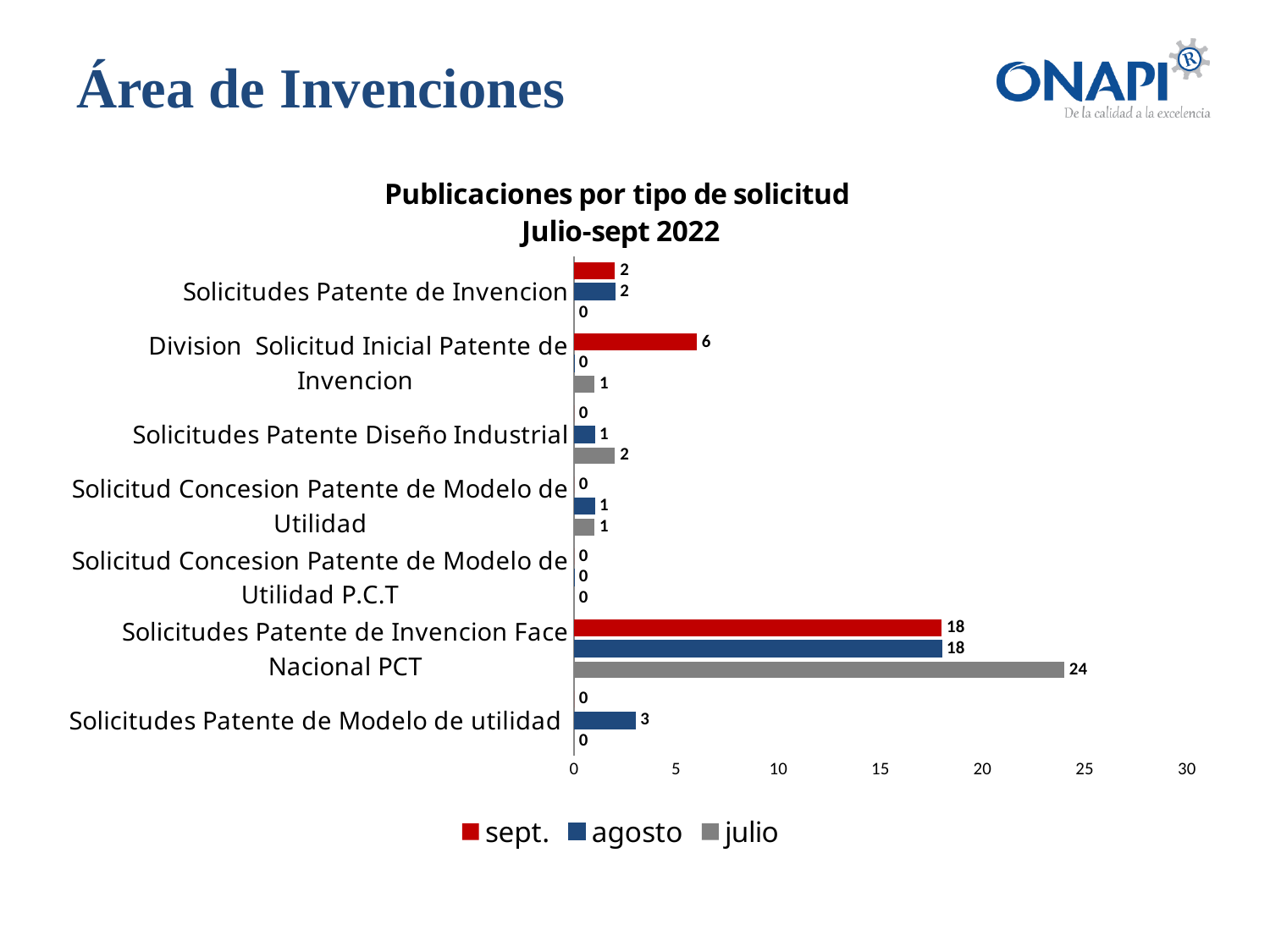
What kind of chart is shown on the slide? bar chart What is the value for agosto for Solicitudes Patente de Modelo de utilidad? 3 What is the difference between the julio and sept. values for Solicitudes Patente de Invencion Face Nacional PCT? 6 What is the value for sept. for Division Solicitud Inicial Patente de Invencion? 6 Which category has the highest value for julio? Solicitudes Patente de Invencion Face Nacional PCT How many categories are shown on the chart? 7 How many series does the legend list? 3 Is the julio value for Solicitudes Patente de Invencion Face Nacional PCT greater or less than 20? greater What is the value for julio for Solicitudes Patente Diseño Industrial? 2 What is the value for julio for Solicitudes Patente de Invencion Face Nacional PCT? 24 What is the title of the chart? Publicaciones por tipo de solicitud Julio-sept 2022 Which is larger for Division Solicitud Inicial Patente de Invencion: the sept. value or the julio value? sept.